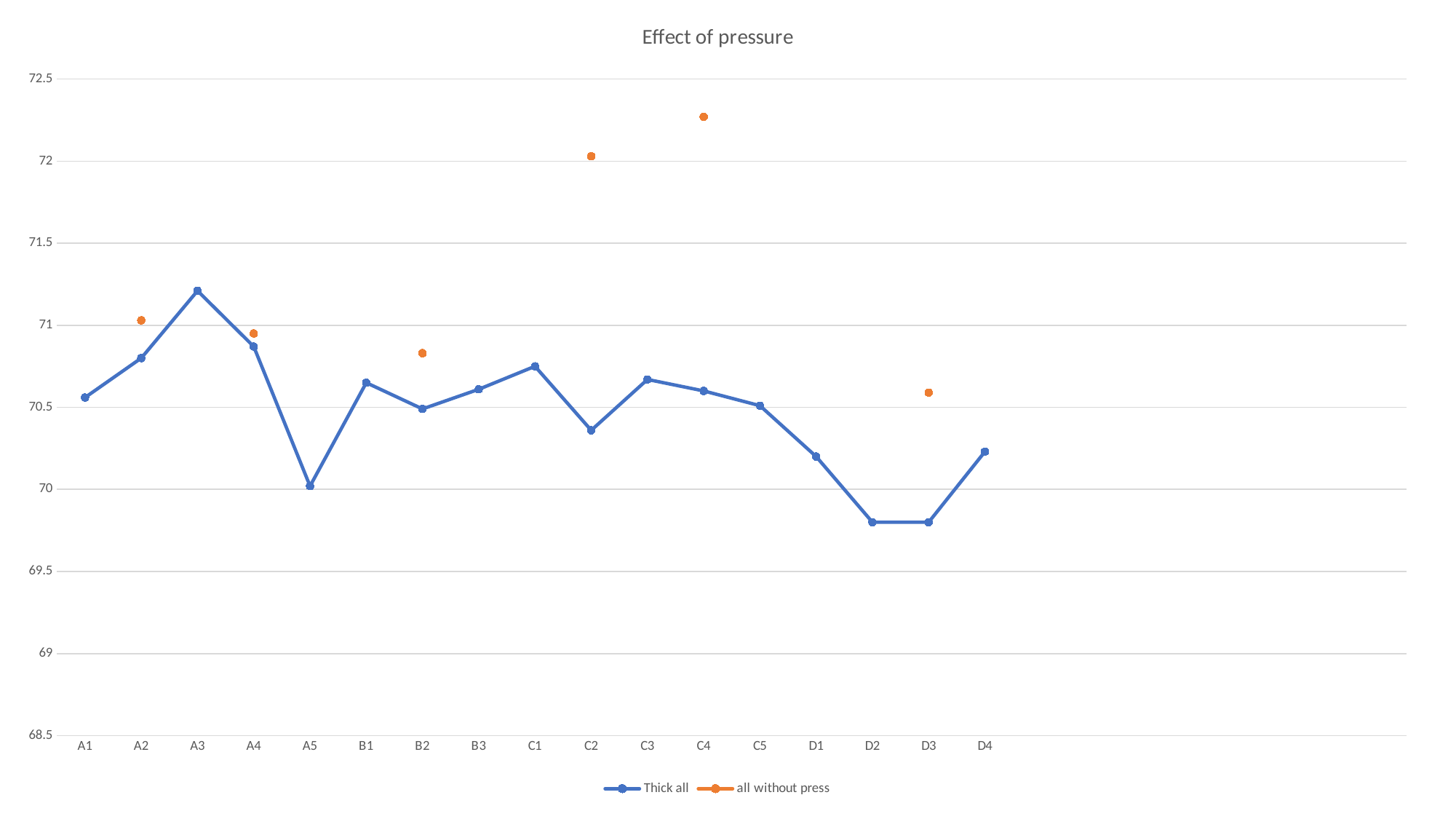
What is the title of the chart? Effect of pressure Does the Thick all series rise or fall from A3 to A5? fall Is the Thick all value for D2 greater or less than 70? less Which category has the highest value for the all without press series? C4 Is the Thick all value for A5 greater or less than 70.5? less How many categories are shown on the x axis? 17 How many series does the legend list? 2 Is the all without press value for C4 greater or less than 72? greater Which category has the lowest value for the all without press series? D3 Which category has the highest value for the Thick all series? A3 What kind of chart is shown on the slide? line chart At C2, which series has the larger value, Thick all or all without press? all without press